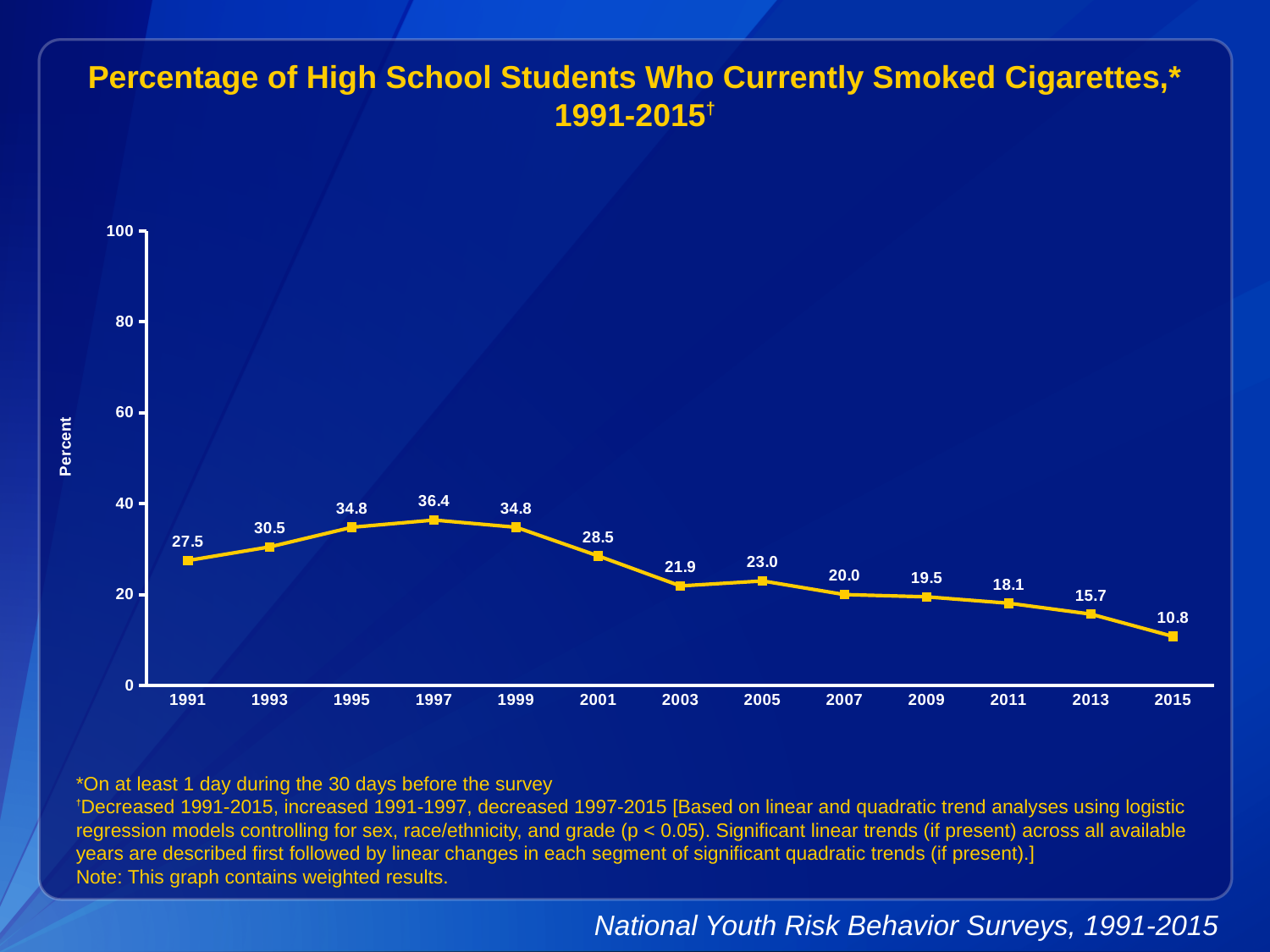
What is the difference between the 1997 value and the 2015 value? 25.6 What percentage of high school students currently smoked cigarettes in 1991? 27.5 In which year was the percentage of students who currently smoked cigarettes highest? 1997 How many years are plotted on the x axis? 13 In which year was the percentage of students who currently smoked cigarettes lowest? 2015 Is the value for 1999 greater or less than 40? less What kind of chart is shown on the slide? line chart What is the value plotted for 2015? 10.8 Which year has the larger value, 1993 or 2001? 1993 What is the difference between the 2003 value and the 2005 value? 1.1 Do the values rise or fall from 1997 to 2015? fall What is the value plotted for 2005? 23.0